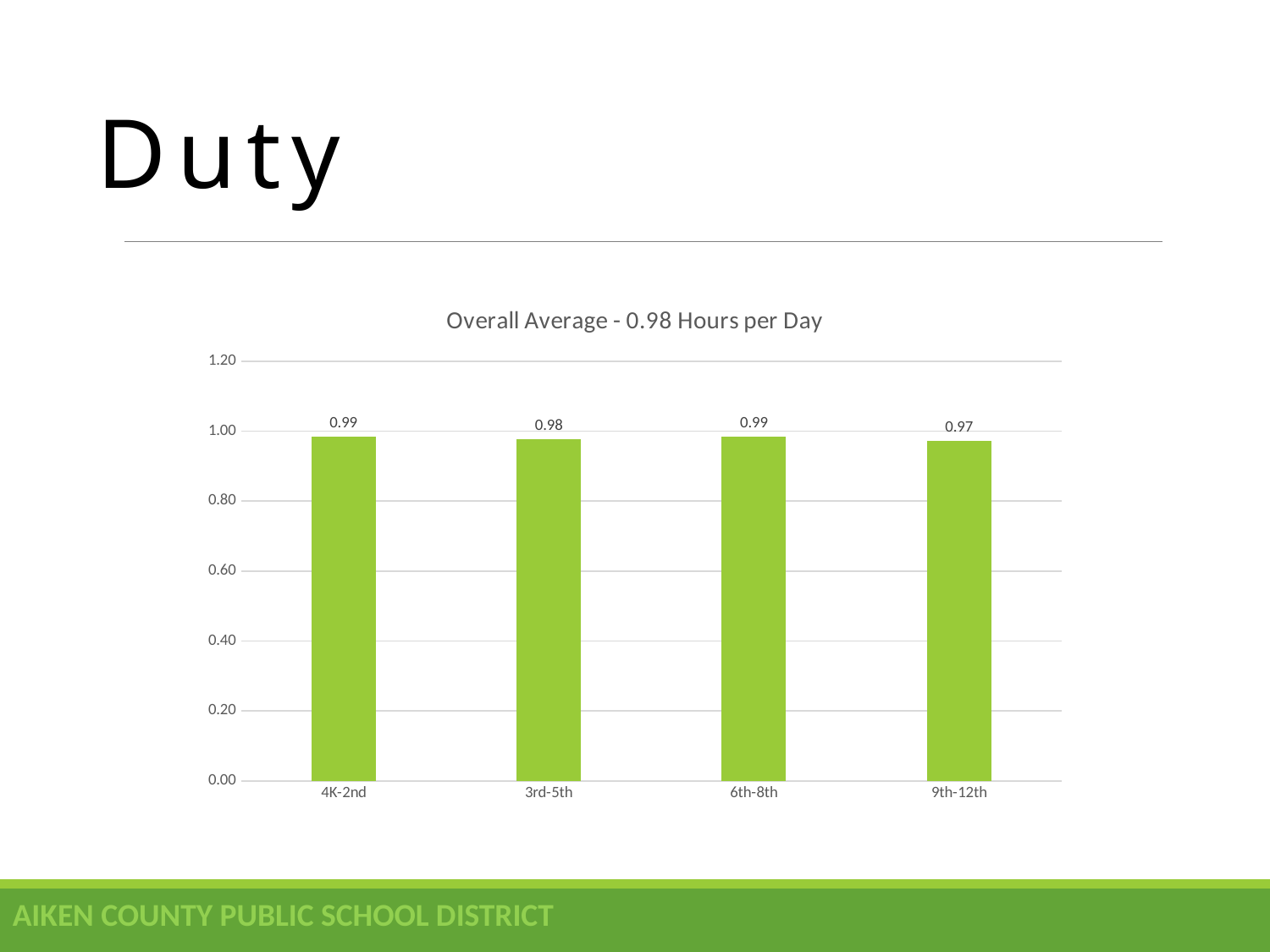
How many grade bands are shown on the chart? 4 Which is larger, the value for 3rd-5th or the value for 9th-12th? 3rd-5th What kind of chart is shown on the slide? bar chart What is the value for 3rd-5th? 0.98 What is the value for 4K-2nd? 0.99 What is the value for 9th-12th? 0.97 What is the difference between the values for 3rd-5th and 9th-12th? 0.01 What is the difference between the values for 4K-2nd and 9th-12th? 0.02 What is the title of the chart? Overall Average - 0.98 Hours per Day Which grade band has the lowest value? 9th-12th Is the value for 9th-12th greater or less than 1.00? less What is the value for 6th-8th? 0.99